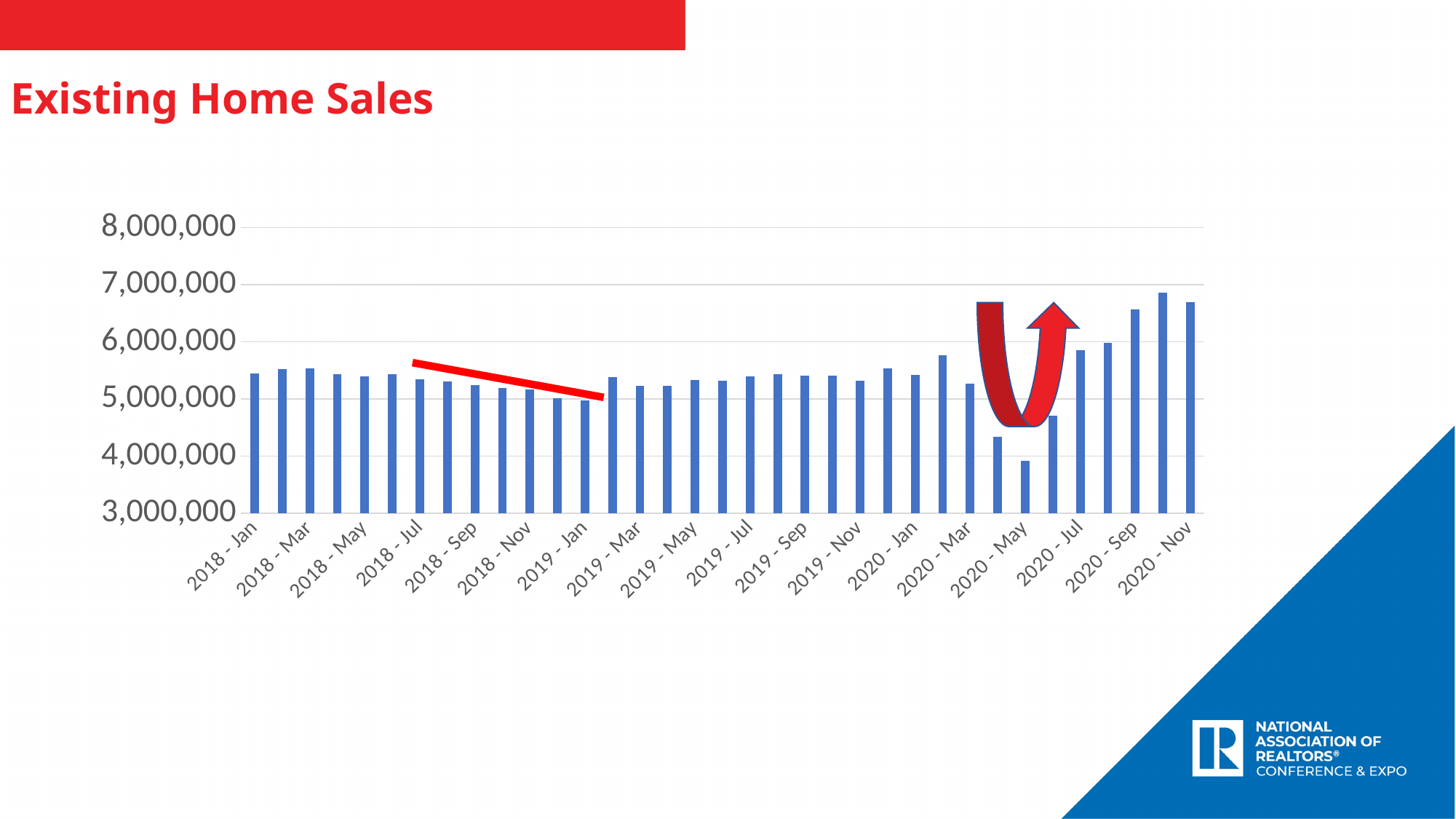
Is the value for 2020 - Sep greater or less than 6,000,000? greater Which month has the lowest existing home sales in the chart? 2020 - May What is the highest value shown on the vertical axis? 8,000,000 Is the value for 2018 - Jan greater or less than 5,000,000? greater What is the title of the slide's chart? Existing Home Sales Is the value for 2020 - Nov greater or less than 6,000,000? greater What kind of chart is shown on the slide? Bar chart Which is larger, the value for 2020 - Nov or the value for 2018 - Jan? 2020 - Nov Which is larger, the value for 2020 - Mar or the value for 2020 - May? 2020 - Mar Do the values rise or fall from 2018 - Jul to 2019 - Jan? fall Do the values rise or fall from 2020 - May to 2020 - Nov? rise